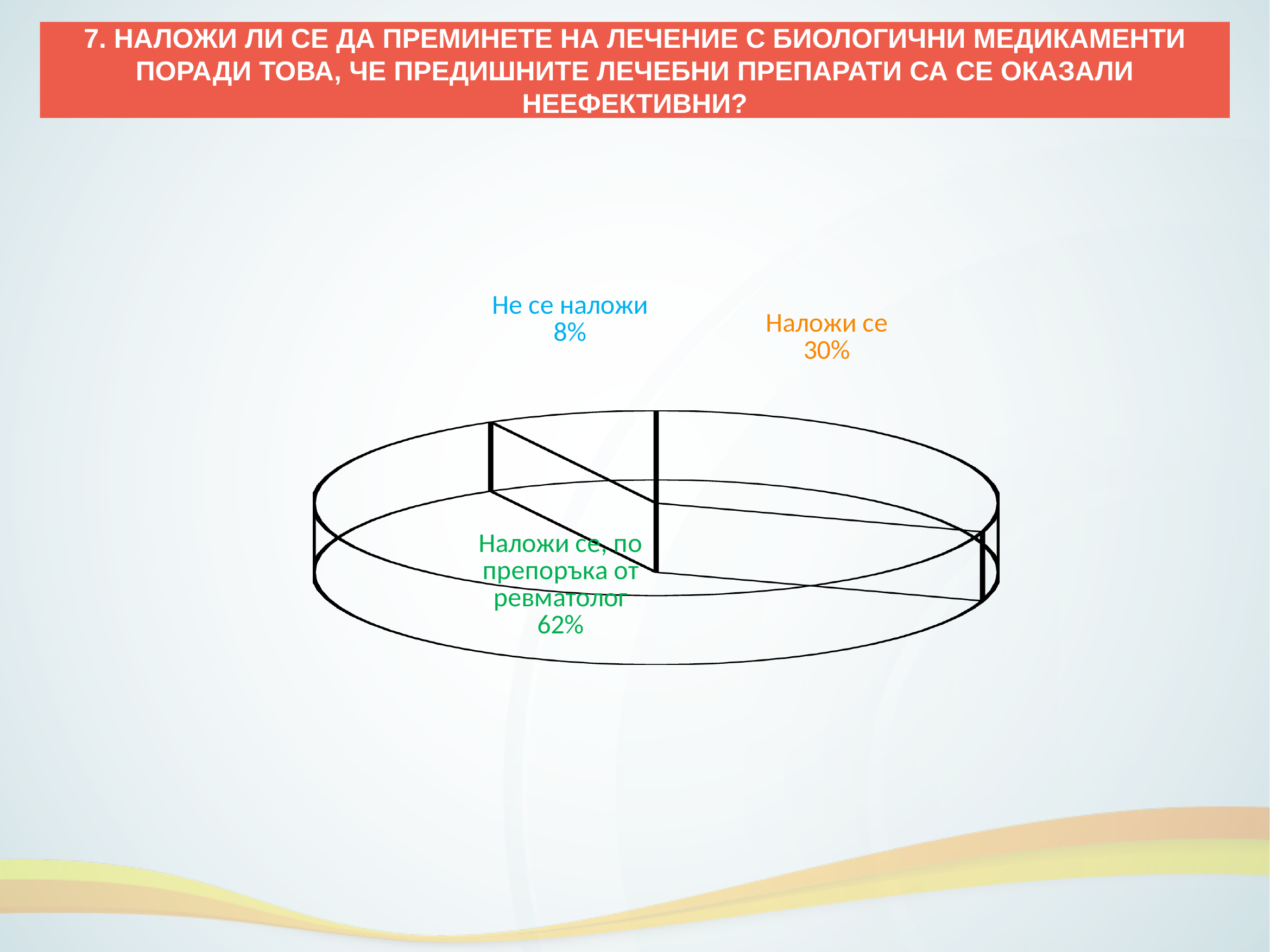
What is the combined share of "Наложи се" and "Наложи се, по препоръка от ревматолог"? 92% Which category has the largest share of the pie? Наложи се, по препоръка от ревматолог Which category has the smallest share of the pie? Не се наложи In what colour is the label "Не се наложи" written? blue What percentage is shown for "Наложи се"? 30% What percentage is shown for "Наложи се, по препоръка от ревматолог"? 62% What kind of chart is shown on the slide? pie chart How many categories does the pie chart show? 3 What is the difference in percentage points between "Наложи се, по препоръка от ревматолог" and "Наложи се"? 32 Which is larger: the share for "Наложи се" or the share for "Не се наложи"? Наложи се What is the difference in percentage points between "Наложи се" and "Не се наложи"? 22 What percentage is shown for "Не се наложи"? 8%